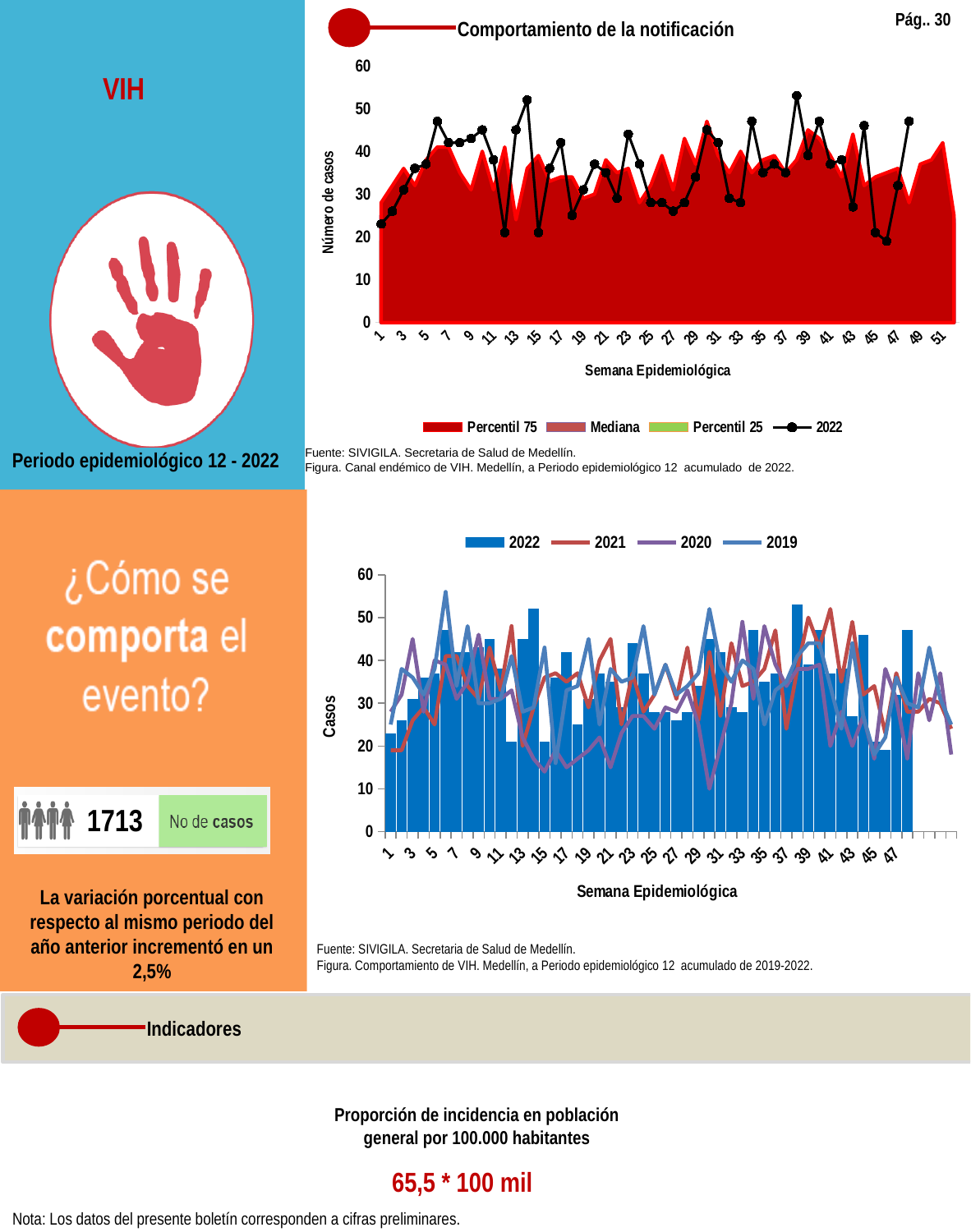
In the bottom chart (Comportamiento de VIH 2019-2022), how many series does the legend list? 4 In the top chart, what are the legend entries? Percentil 75, Mediana, Percentil 25, 2022 In the bottom chart, is the 2022 value for week 47 greater or less than 40? less In the bottom chart, how is the 2022 series plotted? as bars In the bottom chart, is the 2022 value for week 38 greater or less than 50? greater In the top chart, what is the title of the vertical axis? Número de casos In the bottom chart, which is larger for the 2022 series: week 38 or week 39? week 38 In the top chart, is the 2022 value for week 14 greater or less than 40? greater In the top chart (Comportamiento de la notificación), how many series does the legend list? 4 In the top chart, which is larger for the 2022 series: week 14 or week 15? week 14